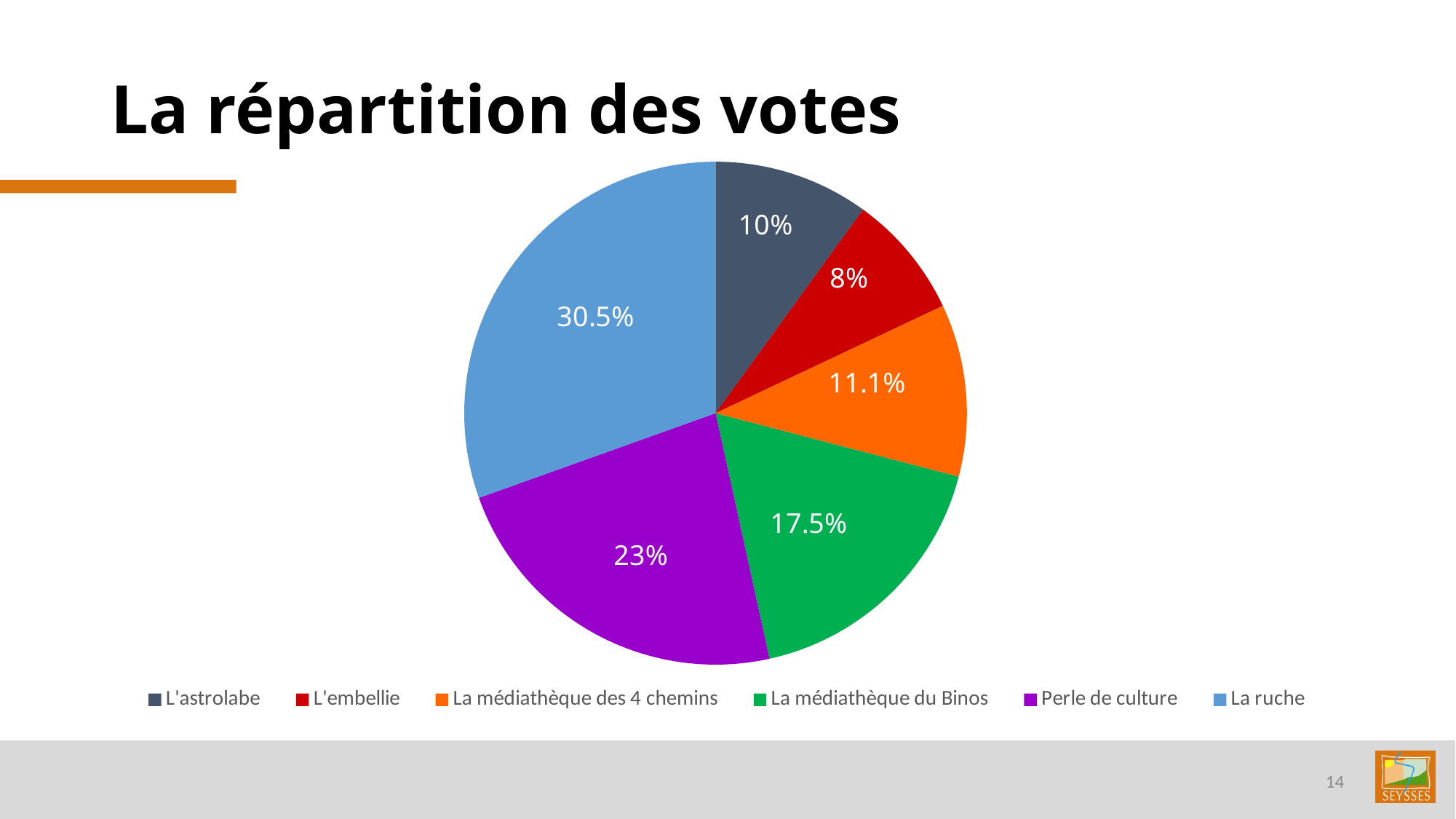
Which received more votes, L'astrolabe or La médiathèque des 4 chemins? La médiathèque des 4 chemins What type of chart is shown on the slide? Pie chart Which option received the smallest share of votes? L'embellie What percentage of votes did Perle de culture receive? 23% Which option received the largest share of votes? La ruche Which colour represents Perle de culture in the pie chart? Purple What is the title of the chart on the slide? La répartition des votes What percentage of votes did L'embellie receive? 8% How many options are shown in the pie chart? 6 What percentage of votes did La ruche receive? 30.5% What percentage of votes did La médiathèque du Binos receive? 17.5% What is the difference in percentage points between La ruche and Perle de culture? 7.5